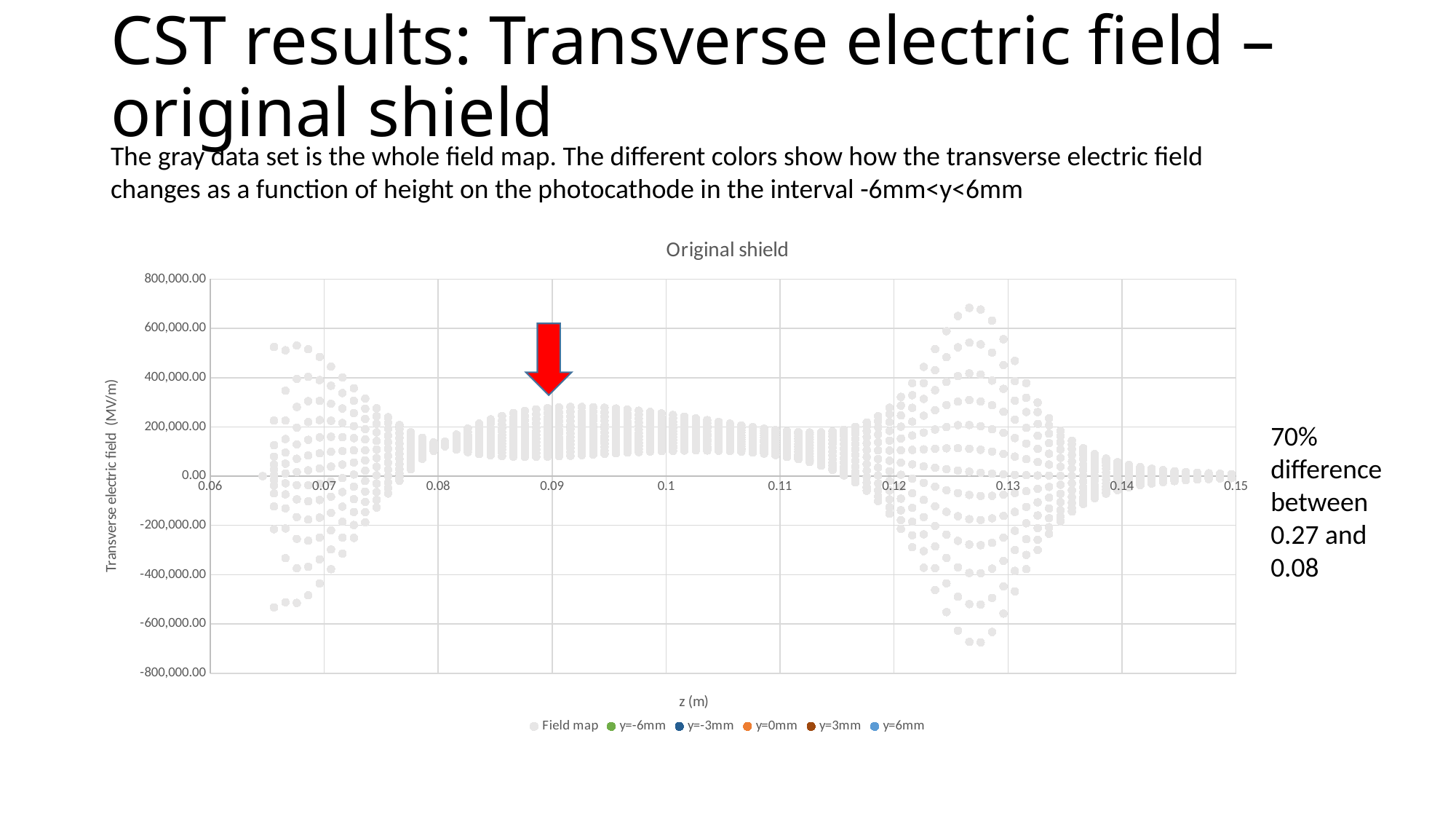
What is the largest z value shown on the x axis of the chart? 0.15 Is the highest Field map value near z = 0.13 greater or less than 600,000.00? greater Is the lowest Field map value near z = 0.13 greater or less than -600,000.00? less Is the highest Field map value near z = 0.07 greater or less than 600,000.00? less What is the lowest value shown on the y axis of the chart? -800,000.00 What kind of chart is shown on the slide? scatter chart What is the title of the chart? Original shield What is the smallest z value shown on the x axis of the chart? 0.06 What is the label of the x axis of the chart? z (m) How many series does the chart legend list? 6 What is the highest value shown on the y axis of the chart? 800,000.00